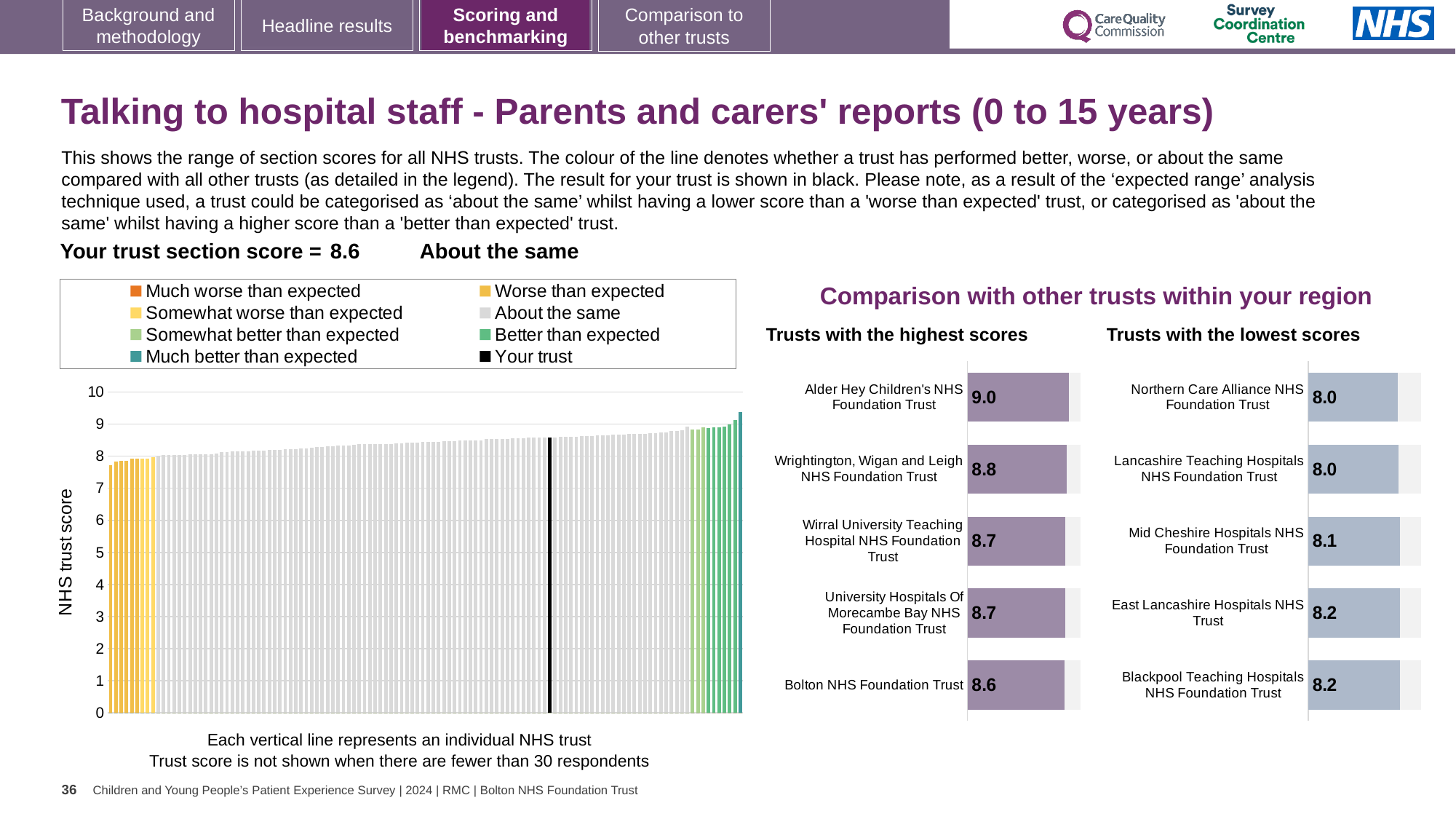
In the 'Trusts with the highest scores' chart, which trust has the highest score? Alder Hey Children's NHS Foundation Trust What kind of chart is the large chart on the left showing the range of section scores for all NHS trusts? Bar chart How many entries does the legend of the large chart on the left list? 8 In the 'Trusts with the highest scores' chart, what is the score for Bolton NHS Foundation Trust? 8.6 How many trusts are shown in the 'Trusts with the lowest scores' chart? 5 In the 'Trusts with the lowest scores' chart, what is the score for Mid Cheshire Hospitals NHS Foundation Trust? 8.1 In the 'Trusts with the highest scores' chart, what is the difference between the scores of Alder Hey Children's NHS Foundation Trust and Bolton NHS Foundation Trust? 0.4 In the large chart on the left showing all NHS trusts, do the bars rise or fall from left to right? Rise In the 'Trusts with the lowest scores' chart, which trust has a higher score: Mid Cheshire Hospitals NHS Foundation Trust or East Lancashire Hospitals NHS Trust? East Lancashire Hospitals NHS Trust In the 'Trusts with the highest scores' chart, what is the score for Alder Hey Children's NHS Foundation Trust? 9.0 In the 'Trusts with the lowest scores' chart, what is the difference between the scores of Blackpool Teaching Hospitals NHS Foundation Trust and Northern Care Alliance NHS Foundation Trust? 0.2 In the large chart on the left showing all NHS trusts, is the value of the tallest bar greater or less than 9? greater